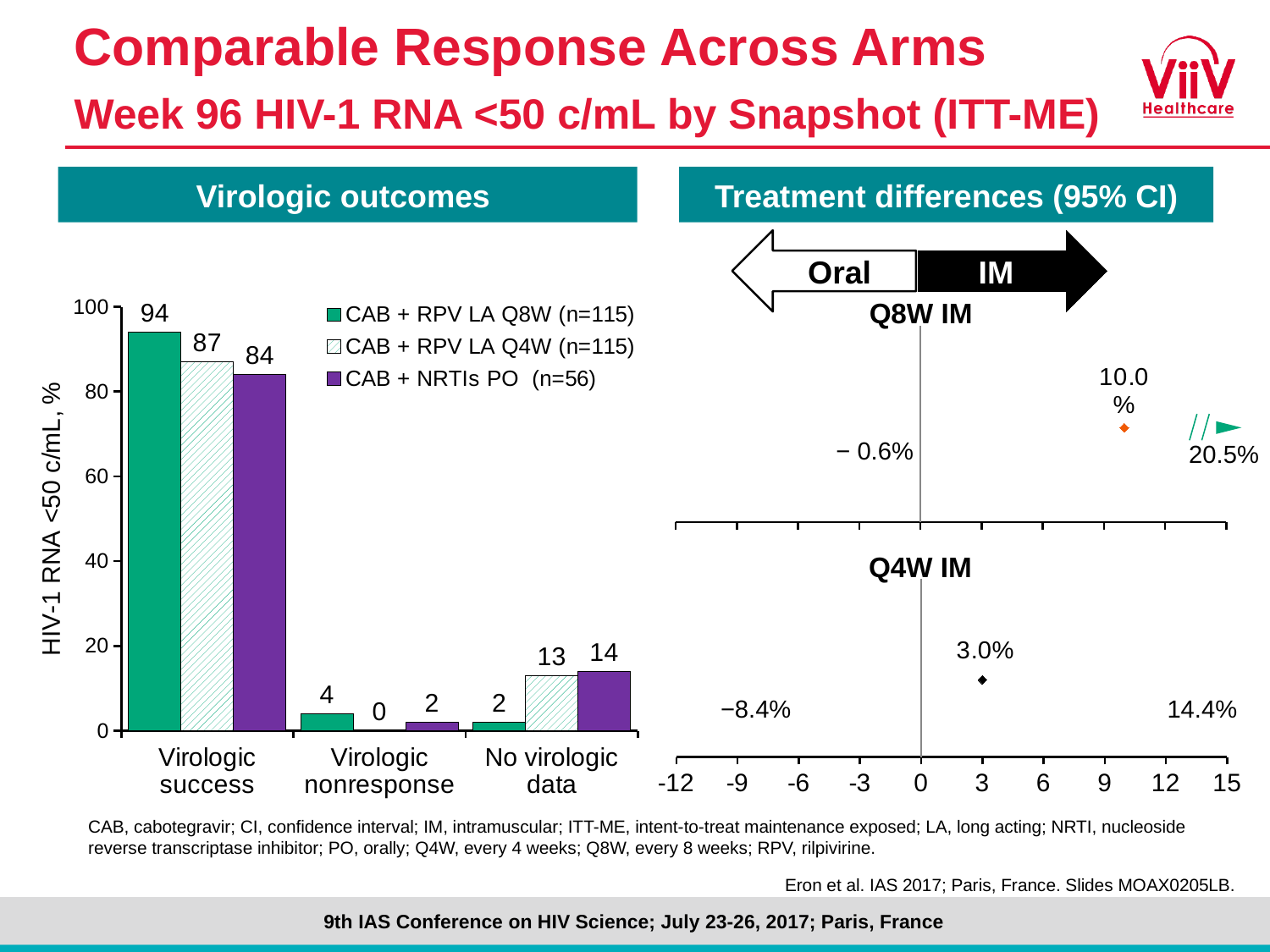
In the Virologic outcomes chart, what is the value for CAB + NRTIs PO (n=56) for No virologic data? 14 How many series does the legend of the Virologic outcomes chart list? 3 In the Virologic outcomes chart, which is larger for No virologic data: CAB + RPV LA Q4W (n=115) or CAB + NRTIs PO (n=56)? CAB + NRTIs PO (n=56) In the Treatment differences (95% CI) chart, what is the lower bound of the confidence interval for Q4W IM? −8.4% In the Virologic outcomes chart, which series has the highest value for Virologic success? CAB + RPV LA Q8W (n=115) In the Virologic outcomes chart, what is the value for CAB + RPV LA Q8W (n=115) for Virologic success? 94 How many categories are shown on the x axis of the Virologic outcomes chart? 3 In the Virologic outcomes chart, what is the difference between the Virologic success values for CAB + RPV LA Q8W (n=115) and CAB + NRTIs PO (n=56)? 10 In the Treatment differences (95% CI) chart, what is the point estimate for Q8W IM? 10.0% In the Virologic outcomes chart, which series has the lowest value for No virologic data? CAB + RPV LA Q8W (n=115) What kind of chart is the Virologic outcomes chart? Bar chart In the Virologic outcomes chart, what is the value for CAB + RPV LA Q4W (n=115) for Virologic nonresponse? 0